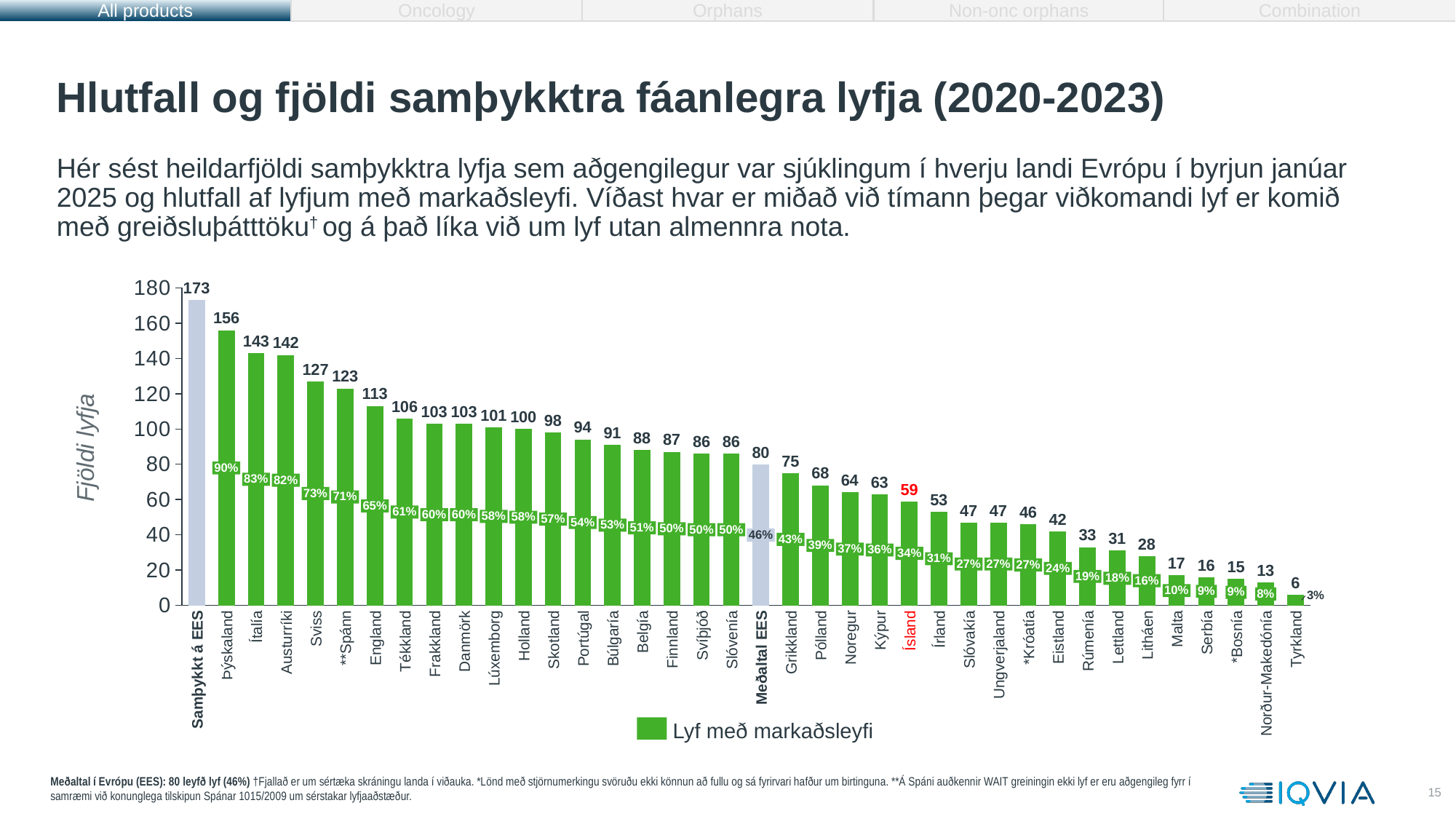
Do the values rise or fall from left to right along the x axis? fall Is the value for Grikkland greater or less than 80? less What is the value for Meðaltal EES? 80 What series does the legend list? Lyf með markaðsleyfi Which is larger, the value for Noregur or the value for Írland? Noregur What percentage is shown on the bar for Sviss? 73% Which category has the lowest value? Tyrkland What is the value for Ísland? 59 What is the value for Þýskaland? 156 Which category has the highest value? Samþykkt á EES What kind of chart is shown on the slide? bar chart What is the difference between the values for Ísland and Meðaltal EES? 21